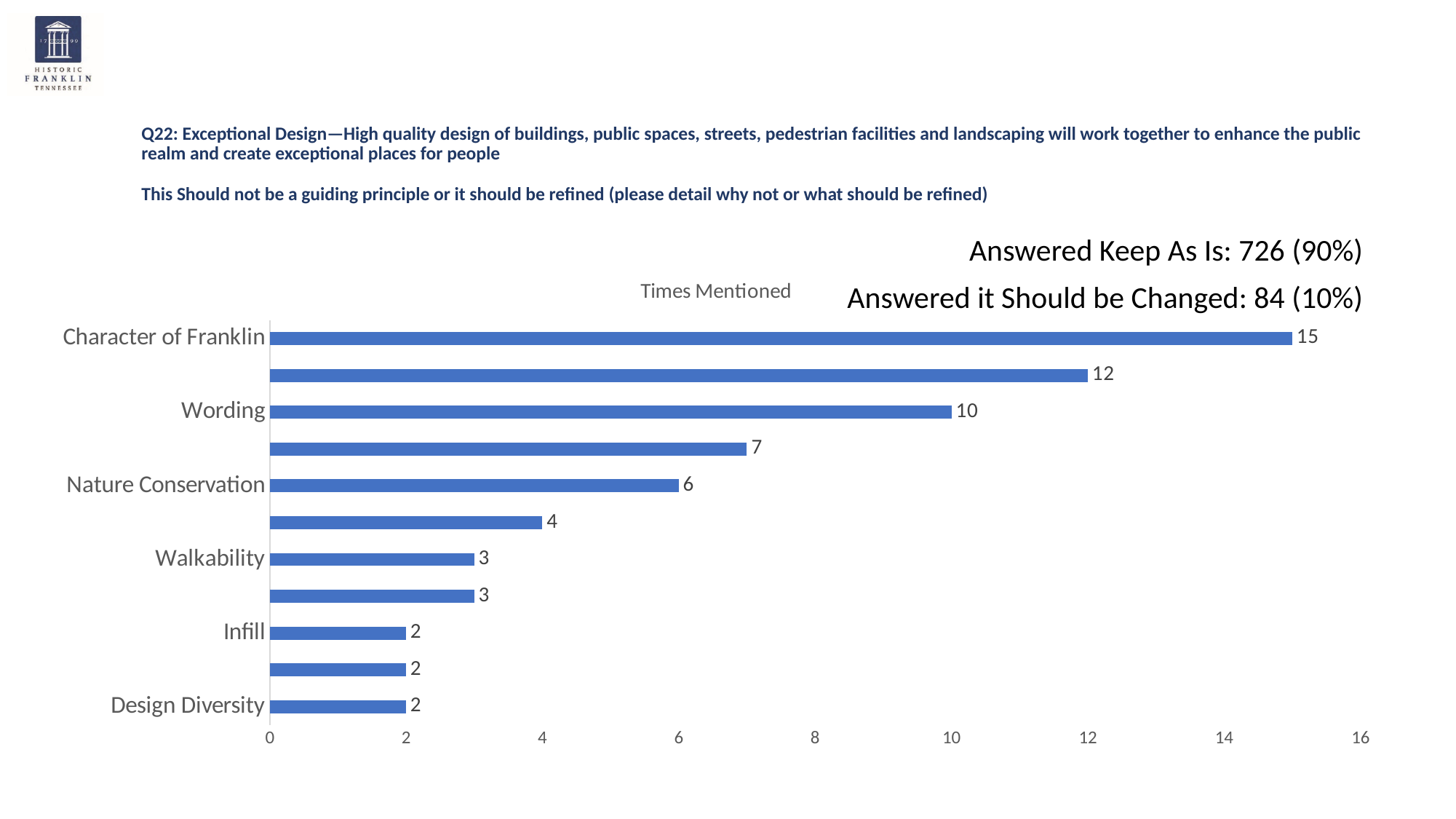
Is the value for Character of Franklin greater or less than 14? greater What kind of chart is shown on the slide? bar chart What is the value for Wording? 10 Which has a larger value, Wording or Nature Conservation? Wording What is the value for Nature Conservation? 6 How many bars are plotted in the chart? 11 What is the value for Design Diversity? 2 What is the value for Walkability? 3 Which category has the highest number of times mentioned? Character of Franklin How many times was Character of Franklin mentioned? 15 What is the title of the chart? Times Mentioned What is the difference between the values for Character of Franklin and Wording? 5